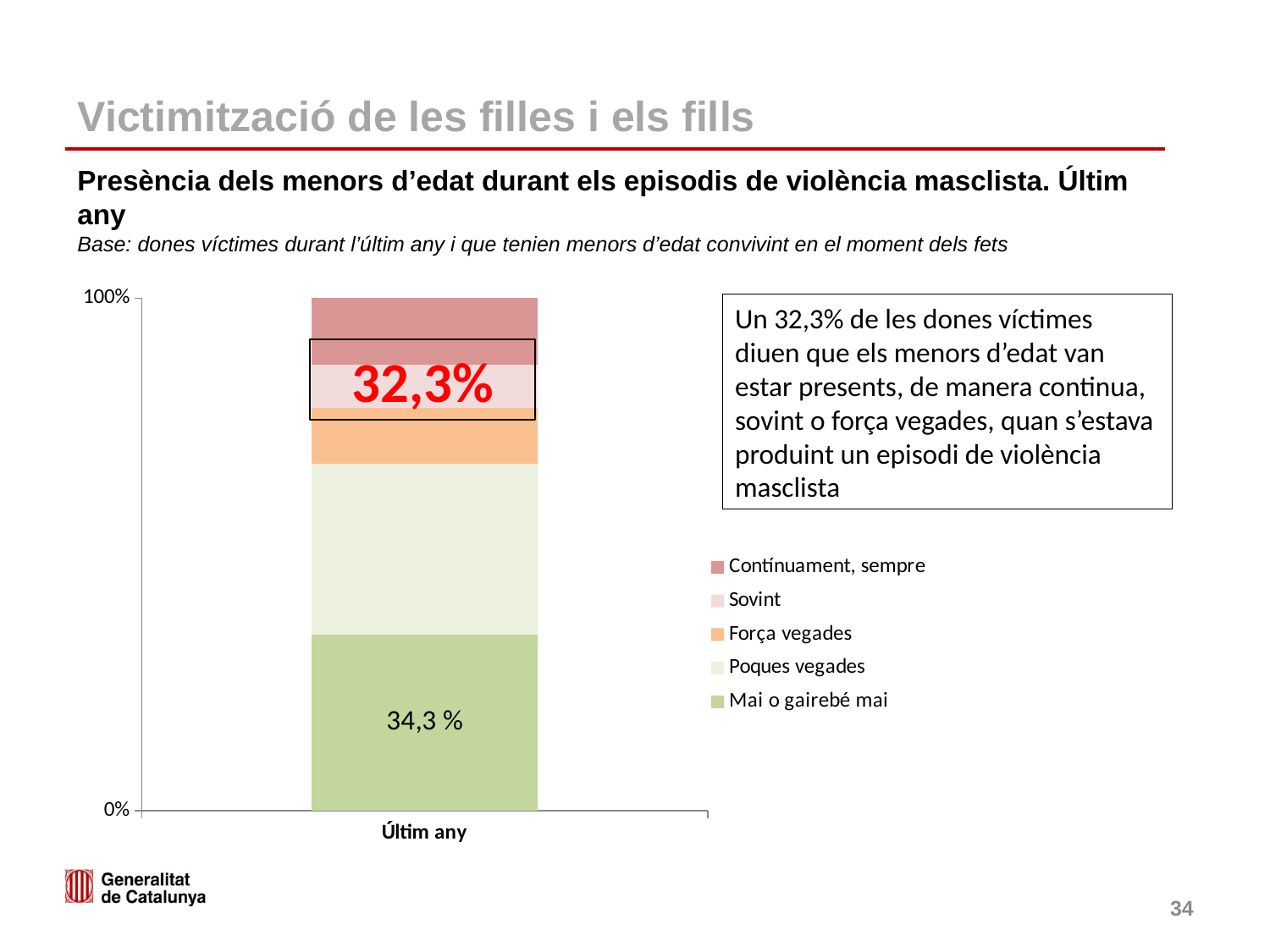
How many series does the legend list? 5 What kind of chart is shown on the slide? Stacked bar chart Is the segment for "Contínuament, sempre" greater or less than 20%? less How many categories are plotted on the x axis? 1 What combined percentage is highlighted for the top three segments (Contínuament, Sovint and Força vegades)? 32,3% What is the difference between the "Mai o gairebé mai" value (34,3 %) and the highlighted combined value (32,3%)? 2 percentage points Is the segment for "Poques vegades" greater or less than 20%? greater Which legend entry is listed first? Contínuament, sempre What is the value shown for "Mai o gairebé mai" in the stacked bar? 34,3 % What is the category label shown on the x axis? Últim any Which is larger, the segment for "Mai o gairebé mai" or the segment for "Força vegades"? Mai o gairebé mai